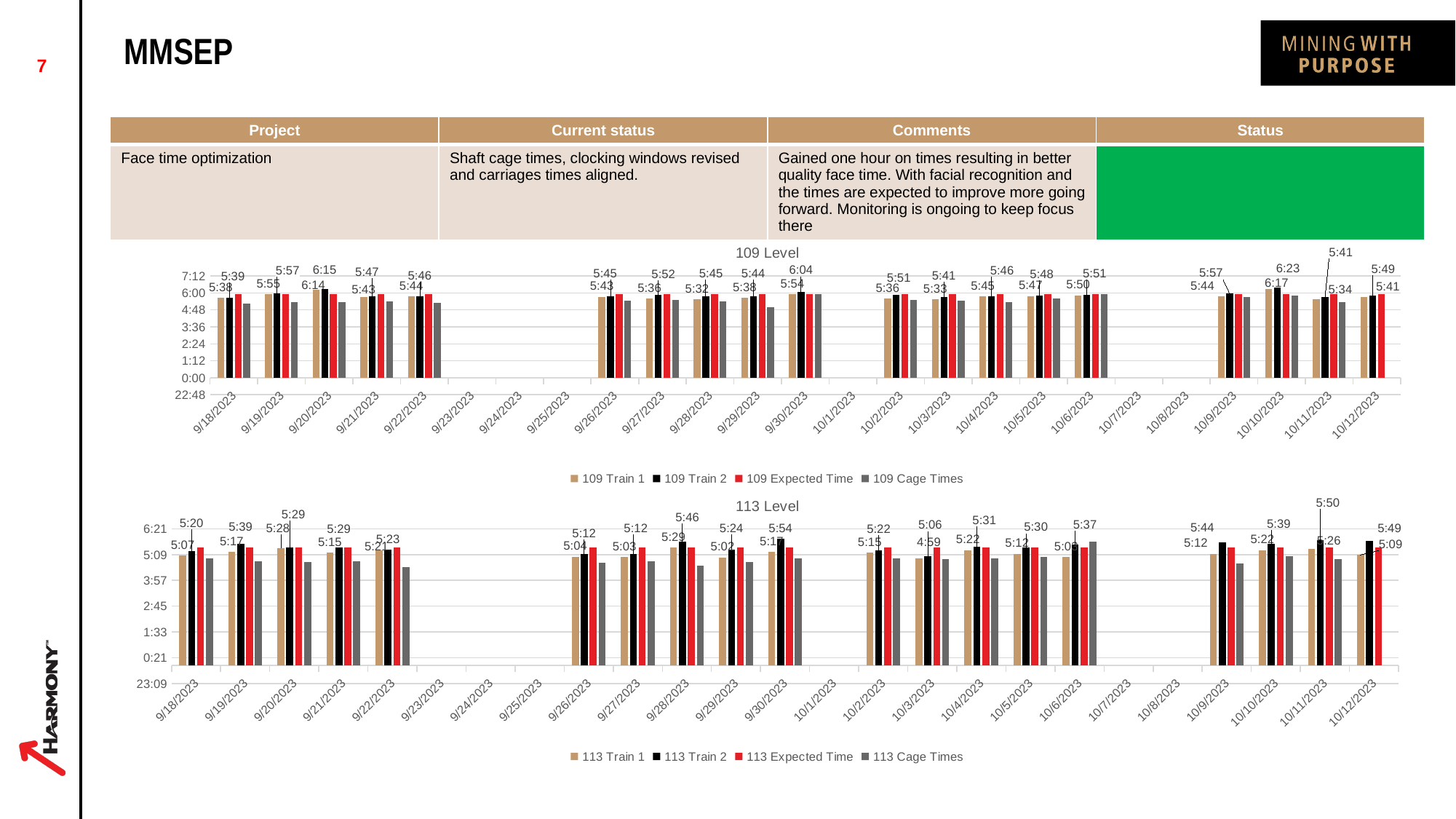
What type of chart is the 113 Level chart? bar chart On the 113 Level chart, which is larger on 9/30/2023: the 113 Train 1 value or the 113 Train 2 value? 113 Train 2 What are the legend entries of the 113 Level chart? 113 Train 1, 113 Train 2, 113 Expected Time, 113 Cage Times On the 109 Level chart, what is the labeled value for 109 Train 1 on 10/10/2023? 6:17 On the 113 Level chart, what is the labeled value for 113 Train 1 on 10/3/2023? 4:59 On the 109 Level chart, on which date does 109 Train 2 reach its highest labeled value? 10/10/2023 On the 109 Level chart, what is the labeled value for 109 Train 2 on 10/10/2023? 6:23 On the 113 Level chart, on which date does 113 Train 1 have its lowest labeled value? 10/3/2023 On the 109 Level chart, is the 109 Cage Times value on 9/18/2023 greater or less than 6:00? less On the 109 Level chart, what is the difference between the 109 Train 2 and 109 Train 1 labeled values on 10/10/2023? 6 minutes On the 109 Level chart, how many series does the legend list? 4 On the 113 Level chart, what is the labeled value for 113 Train 2 on 9/28/2023? 5:46